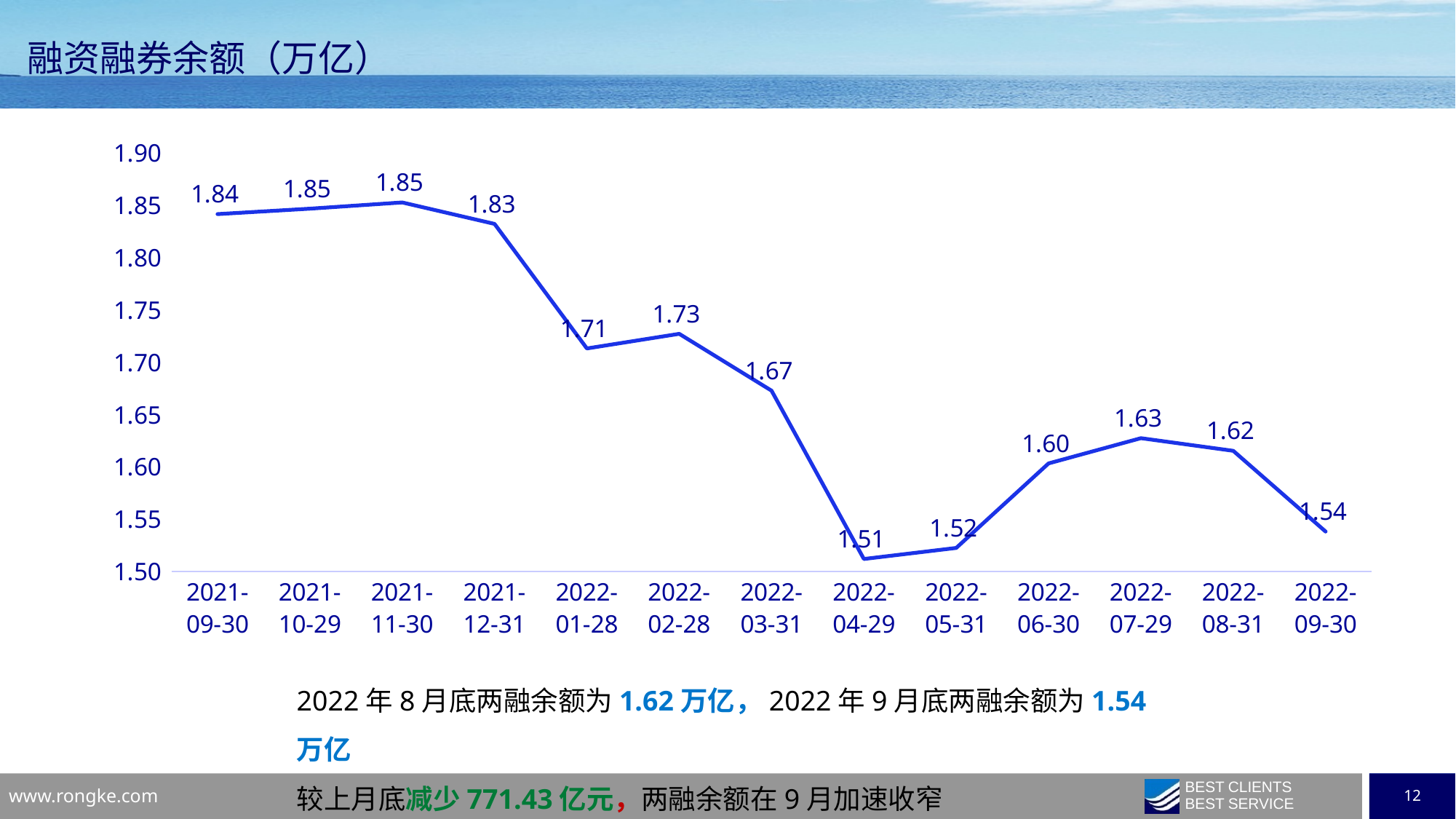
Which date has the lowest value? 2022-04-29 What is the value for 2021-12-31? 1.83 What is the difference between the values for 2022-08-31 and 2022-09-30? 0.08 What is the title of the chart? 融资融券余额（万亿） Do the values generally rise or fall from 2021-09-30 to 2022-09-30? fall What is the value for 2022-03-31? 1.67 What type of chart is shown on the slide? line chart What is the value for 2022-09-30? 1.54 Is the value for 2022-06-30 greater or less than 1.65? less How many data points are plotted on the chart? 13 Which is larger, the value for 2022-01-28 or the value for 2022-02-28? 2022-02-28 What is the difference between the values for 2021-09-30 and 2022-04-29? 0.33